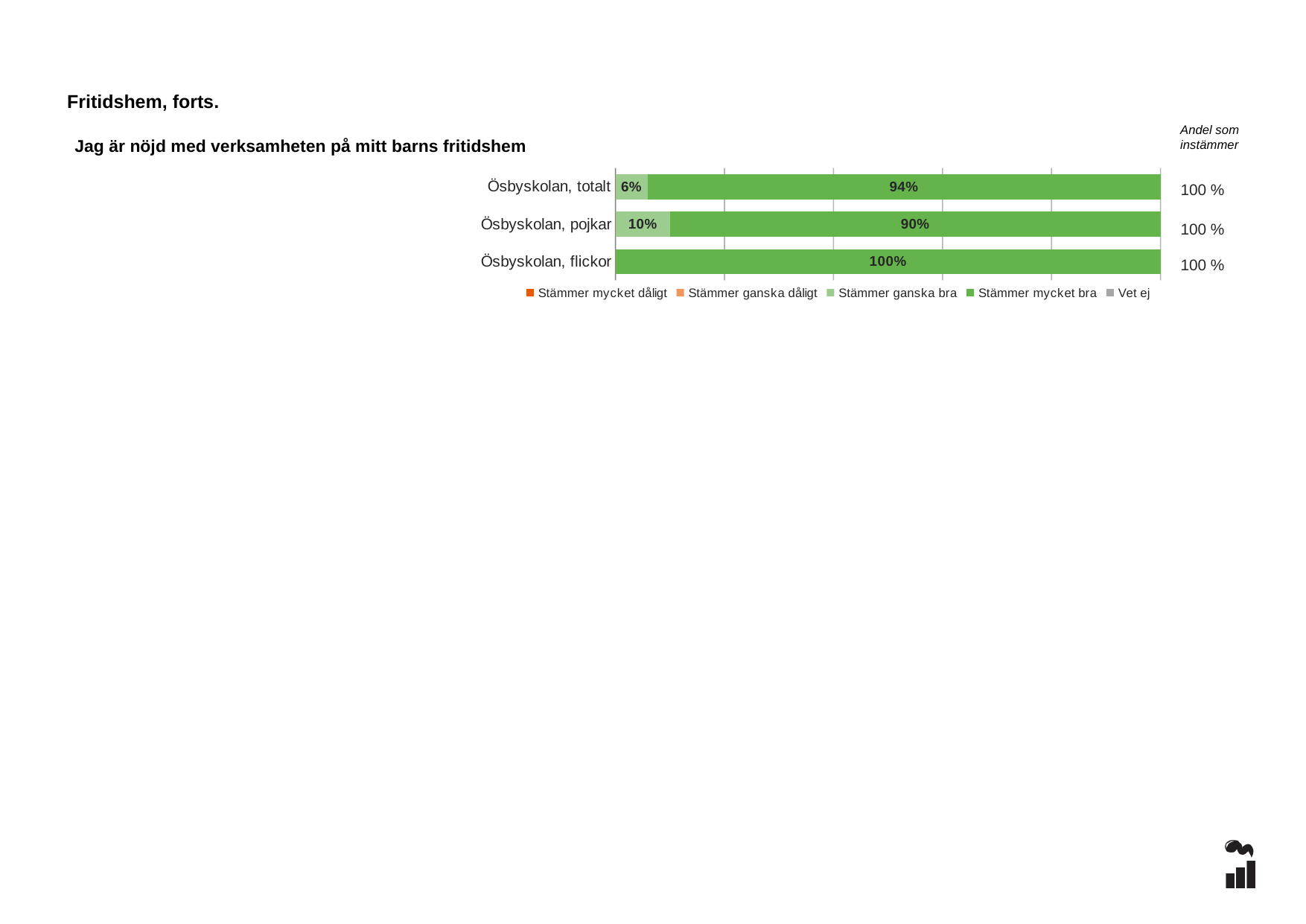
How many series does the legend list? 5 What kind of chart is shown on the slide? Stacked bar chart What is the value of "Stämmer mycket bra" for Ösbyskolan, flickor? 100% What is the value of "Stämmer mycket bra" for Ösbyskolan, totalt? 94% What is the "Andel som instämmer" value shown for Ösbyskolan, pojkar? 100 % What is the value of "Stämmer ganska bra" for Ösbyskolan, pojkar? 10% Which category has the lowest value for "Stämmer mycket bra"? Ösbyskolan, pojkar What is the value of "Stämmer ganska bra" for Ösbyskolan, totalt? 6% How many categories are shown on the chart? 3 Which category has the highest value for "Stämmer mycket bra"? Ösbyskolan, flickor What is the difference between the "Stämmer mycket bra" values for Ösbyskolan, totalt and Ösbyskolan, pojkar? 4 percentage points Which is larger: the "Stämmer ganska bra" value for Ösbyskolan, pojkar or for Ösbyskolan, totalt? Ösbyskolan, pojkar